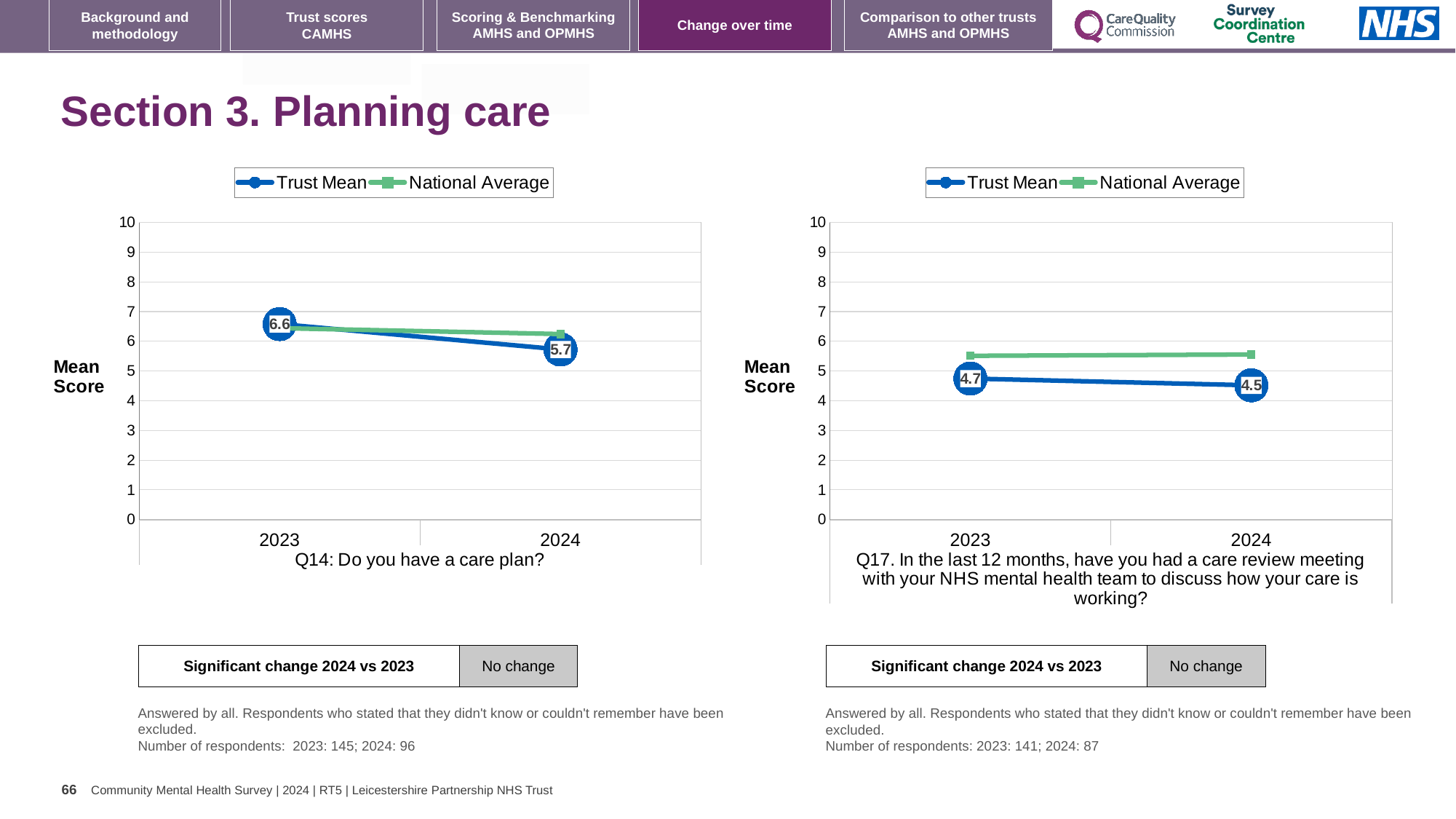
In the Q17 chart (right), what is the Trust Mean score for 2023? 4.7 In the Q17 chart (right), what is the Trust Mean score for 2024? 4.5 How many series does the legend of the Q14 chart (left) list? 2 In the Q17 chart (right), what is the difference between the Trust Mean in 2023 and 2024? 0.2 What kind of chart is the Q17 chart (right)? line chart In the Q17 chart (right), which series is higher in 2024, Trust Mean or National Average? National Average In the Q17 chart (right), is the National Average for 2024 greater or less than 5? greater In the Q14 chart (left), what is the Trust Mean score for 2023? 6.6 How many years are plotted on the x axis of the Q14 chart (left)? 2 In the Q14 chart (left), what is the Trust Mean score for 2024? 5.7 In the Q14 chart (left), by how much did the Trust Mean fall from 2023 to 2024? 0.9 In the Q14 chart (left), does the Trust Mean rise or fall from 2023 to 2024? fall